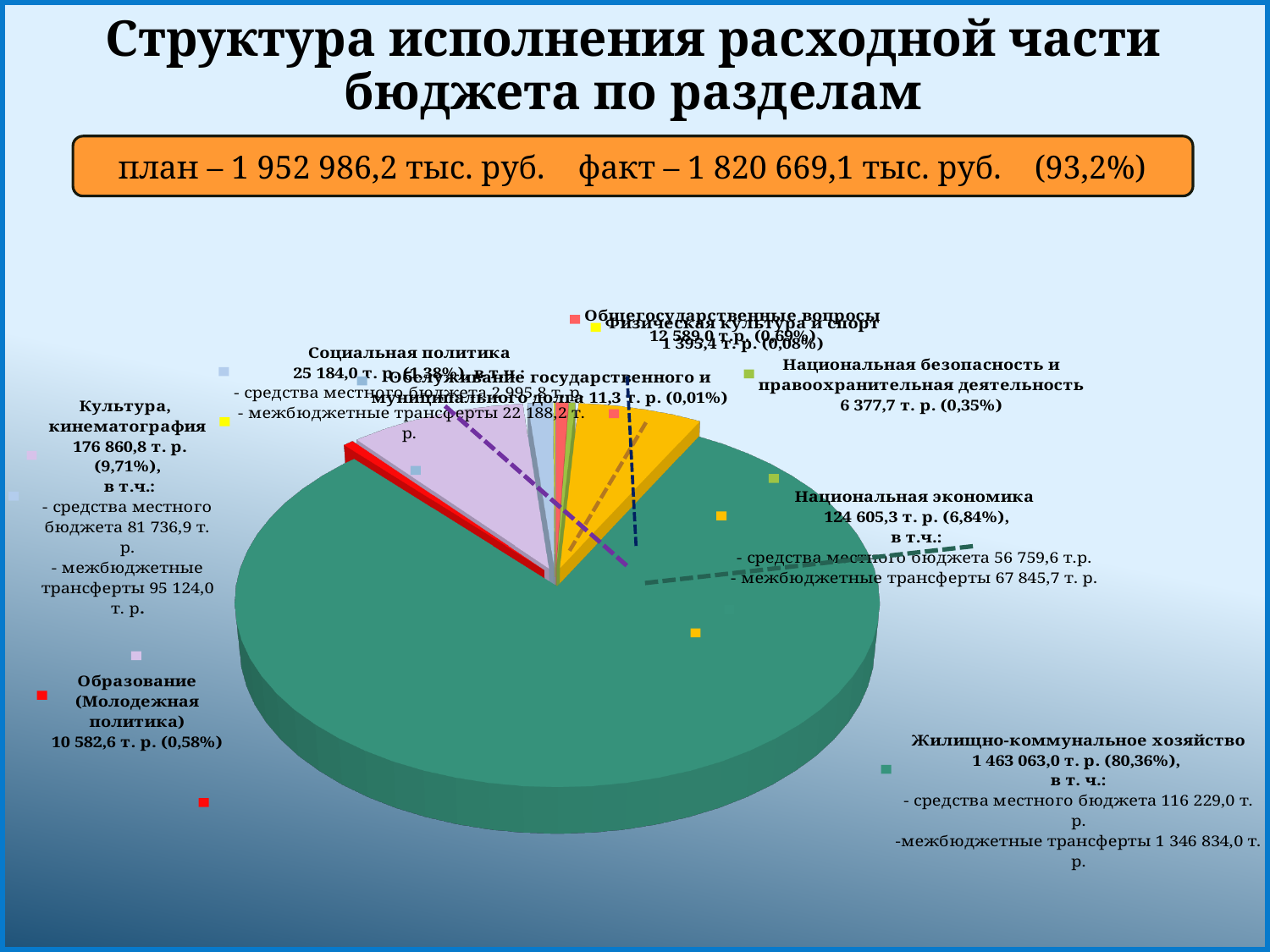
Which section has the smallest share of the pie? Обслуживание государственного и муниципального долга What share of the pie does Жилищно-коммунальное хозяйство represent? 80,36% What is the title of the slide's chart? Структура исполнения расходной части бюджета по разделам Which section has the largest share of the pie? Жилищно-коммунальное хозяйство What kind of chart is shown on the slide? Pie chart What is the difference between the values for Культура, кинематография and Национальная экономика? 52 255,5 т. р. What is the value for Жилищно-коммунальное хозяйство? 1 463 063,0 т. р. Which is larger: Культура, кинематография or Национальная экономика? Культура, кинематография What is the value for Культура, кинематография? 176 860,8 т. р. How many sections (slices) does the pie chart show? 9 What share of the pie does Национальная экономика represent? 6,84% What is the value for Образование (Молодежная политика)? 10 582,6 т. р.